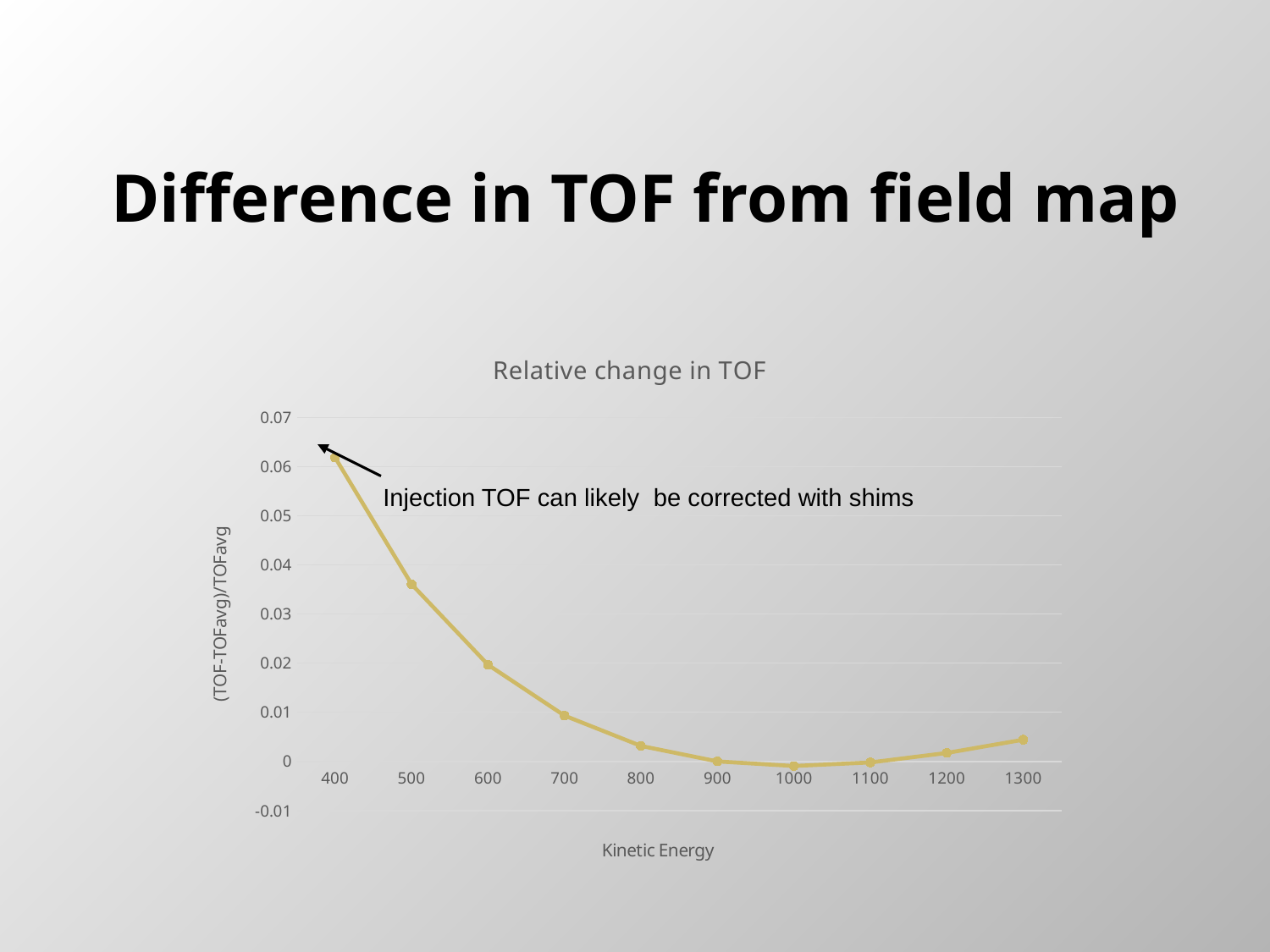
Is the value at kinetic energy 600 greater or less than 0.03? less What is the title of the chart? Relative change in TOF Which has the larger value, kinetic energy 500 or kinetic energy 600? 500 What is the label of the x axis? Kinetic Energy Is the value at kinetic energy 1300 greater or less than 0.01? less How many data points are plotted on the line? 10 At which kinetic energy is the relative change in TOF highest? 400 Does the relative change in TOF rise or fall as kinetic energy increases from 400 to 900? fall Is the value at kinetic energy 400 greater or less than 0.05? greater What kind of chart is shown on the slide? line chart